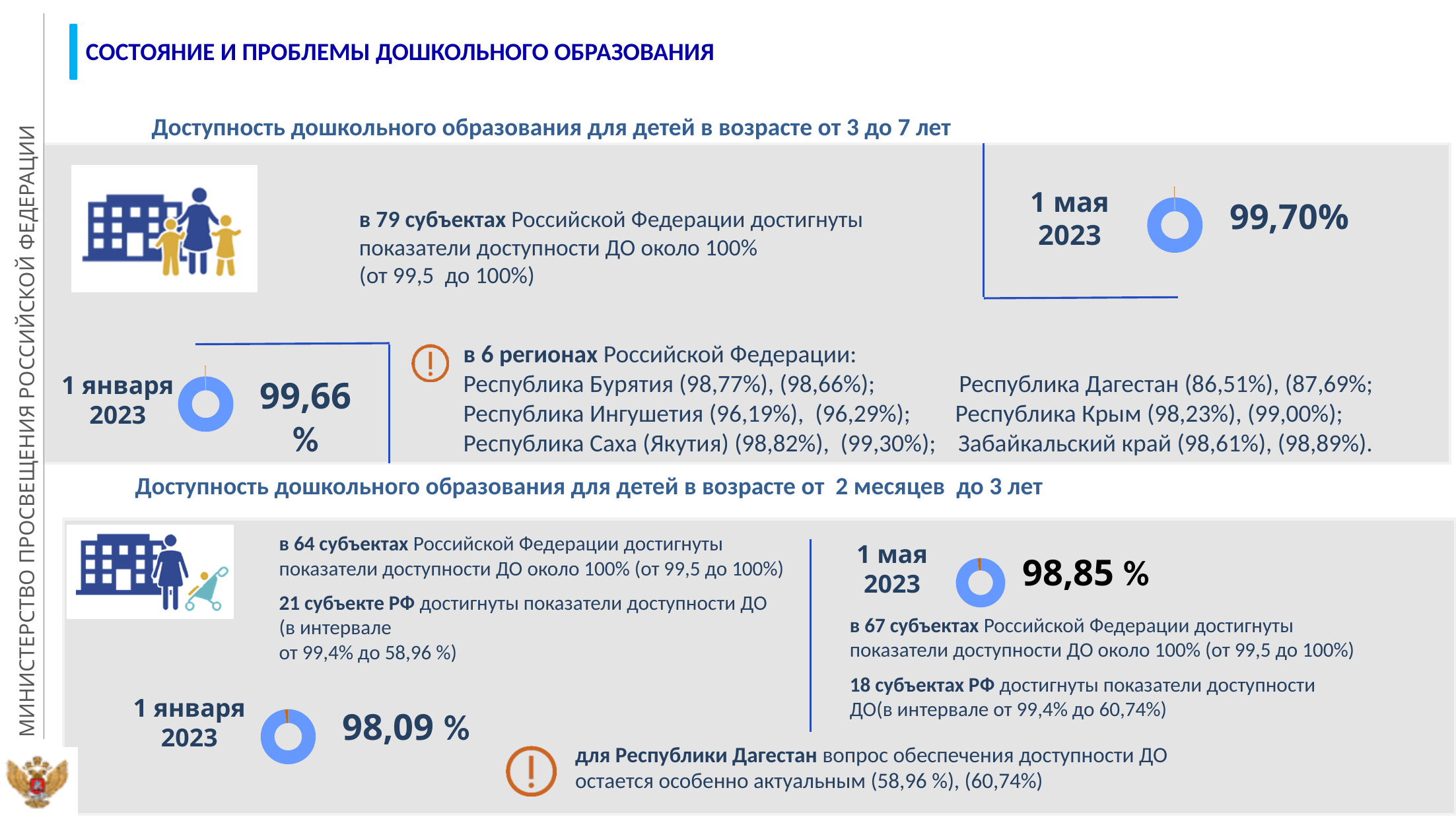
Of the four donut charts on the slide, which one shows the lowest value? 1 января 2023 (от 2 месяцев до 3 лет), 98,09 % On the donut chart for 1 января 2023 in the section 'Доступность дошкольного образования для детей в возрасте от 2 месяцев до 3 лет', what value is shown? 98,09 % Of the four donut charts on the slide, which one shows the highest value? 1 мая 2023 (от 3 до 7 лет), 99,70% In the section for children aged 2 months to 3 years, by how many percentage points did the value change from 1 января 2023 to 1 мая 2023? 0,76 How many donut charts are shown on the slide? 4 On the donut chart for 1 мая 2023 in the section for children aged 2 months to 3 years, what value is shown? 98,85 % On the donut chart for 1 января 2023 in the section 'Доступность дошкольного образования для детей в возрасте от 3 до 7 лет', what value is shown? 99,66 % In the section for children aged 2 months to 3 years, which date has the lower accessibility value, 1 января 2023 or 1 мая 2023? 1 января 2023 In the section for children aged 3 to 7 years, by how many percentage points did the value change from 1 января 2023 to 1 мая 2023? 0,04 What kind of chart is used to display the accessibility values on the slide? Donut chart In the section for children aged 3 to 7 years, which date has the higher accessibility value, 1 января 2023 or 1 мая 2023? 1 мая 2023 On the donut chart for 1 мая 2023 in the section for children aged 3 to 7 years, what value is shown? 99,70%